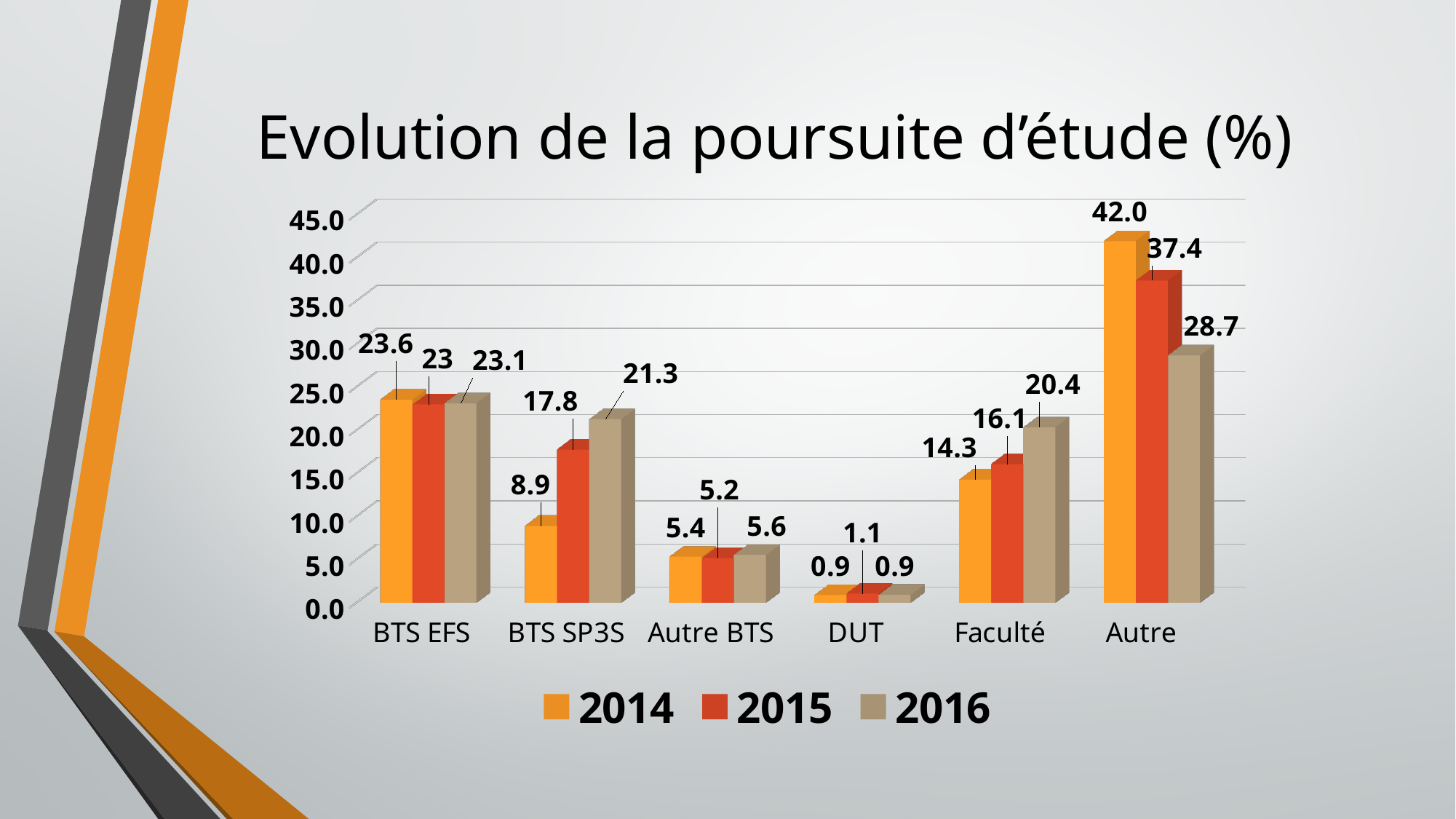
How many categories are shown on the x axis? 6 Which category has the lowest value in 2014? DUT What kind of chart is shown on the slide? bar chart How many series does the legend list? 3 Which category has the highest value in 2016? Autre What is the value for Faculté in 2015? 16.1 What is the difference between the 2014 and 2016 values for Autre? 13.3 What is the value for Autre in 2014? 42.0 What is the difference between the 2016 and 2014 values for BTS SP3S? 12.4 What is the value for BTS SP3S in 2016? 21.3 Do the values for BTS SP3S rise or fall from 2014 to 2016? rise Which is larger for Faculté: the 2014 value or the 2016 value? 2016